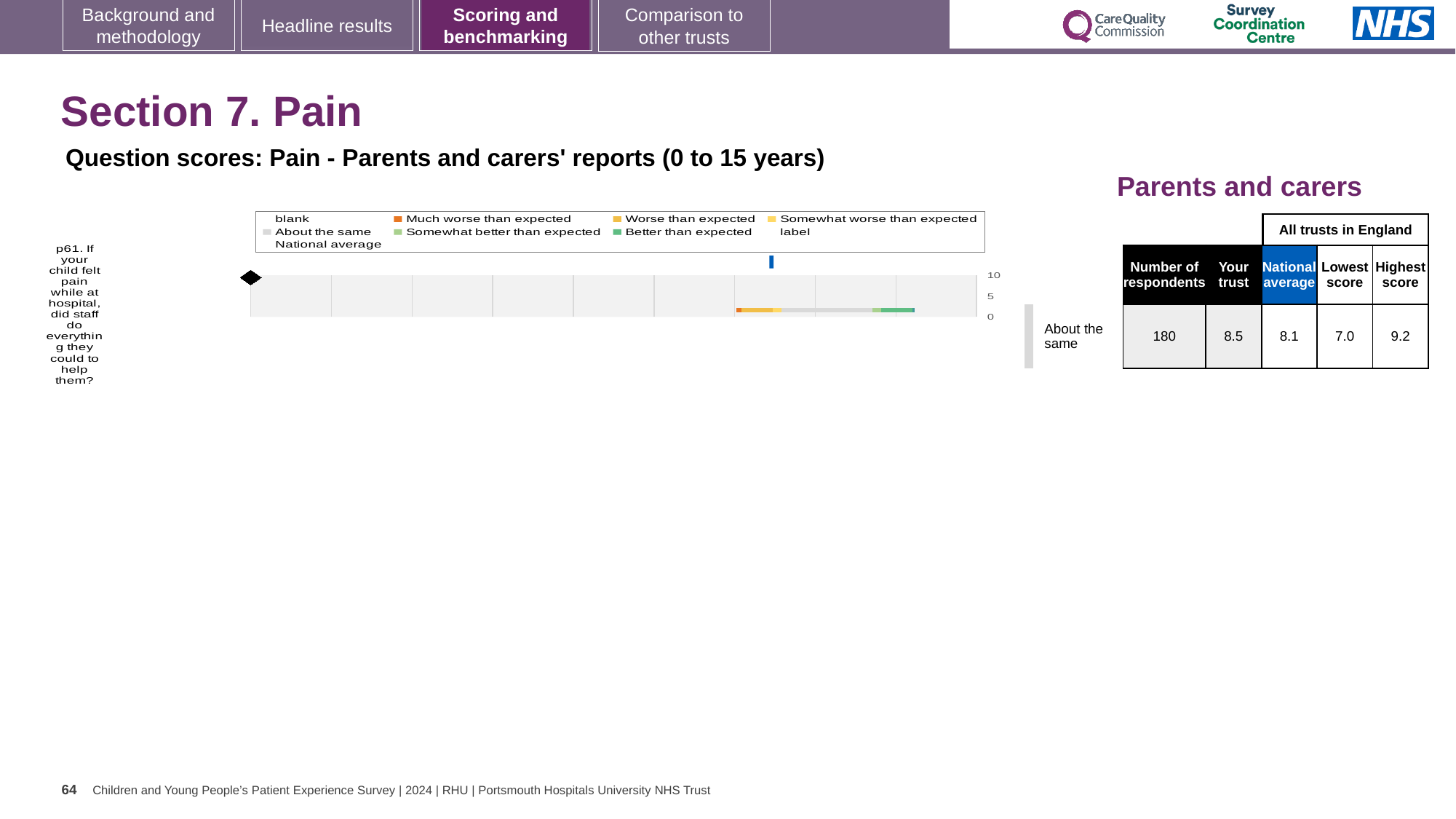
Is the Your trust score greater or less than 5? greater What is the highest tick value shown on the chart's axis? 10 What kind of chart is shown on the slide for question p61? bar chart How many respondents are listed in the Parents and carers table? 180 Which is larger, the Your trust score or the National average score? Your trust In the Parents and carers table, what is the score for Your trust for 'About the same'? 8.5 What is the difference between the Highest score and the Lowest score in the table? 2.2 In the Parents and carers table, what is the National average score? 8.1 What is the difference between the Your trust score and the National average score? 0.4 In the Parents and carers table, what is the Lowest score among all trusts in England? 7.0 In the Parents and carers table, what is the Highest score among all trusts in England? 9.2 Which question is plotted in the chart? p61. If your child felt pain while at hospital, did staff do everything they could to help them?